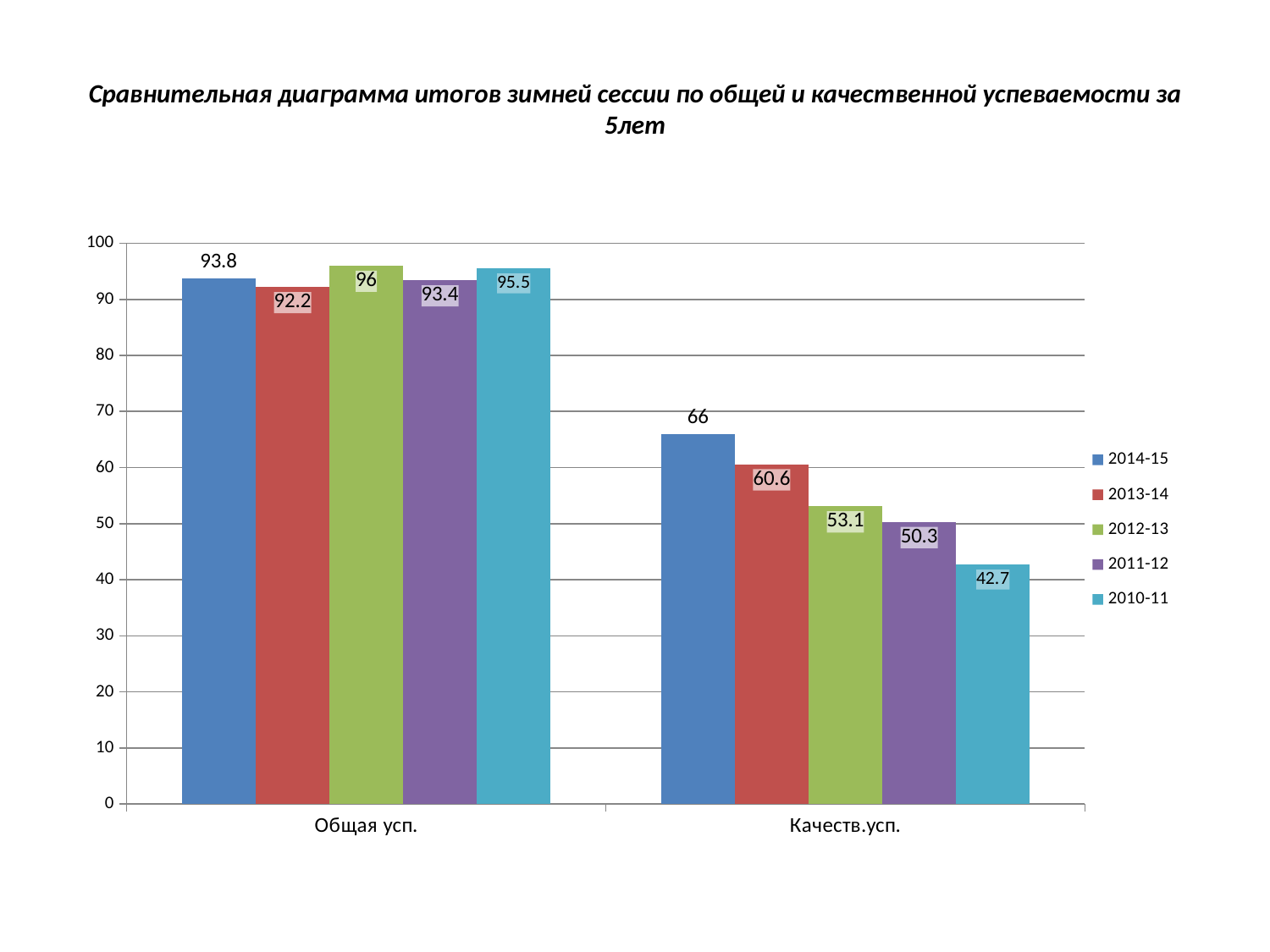
Is the value for 2013-14 in the Качеств.усп. category greater or less than 60? greater How many series does the legend list? 5 Which series has the lowest value in the Качеств.усп. category? 2010-11 What is the value for 2014-15 in the Общая усп. category? 93.8 What is the value for 2012-13 in the Общая усп. category? 96 What is the value for 2010-11 in the Качеств.усп. category? 42.7 How many categories are shown on the x axis? 2 Which is larger in the Общая усп. category: the value for 2013-14 or the value for 2010-11? 2010-11 Which colour represents the 2012-13 series in the legend? green What is the difference between the 2014-15 and 2010-11 values in the Качеств.усп. category? 23.3 What kind of chart is shown on the slide? bar chart Which series has the highest value in the Общая усп. category? 2012-13